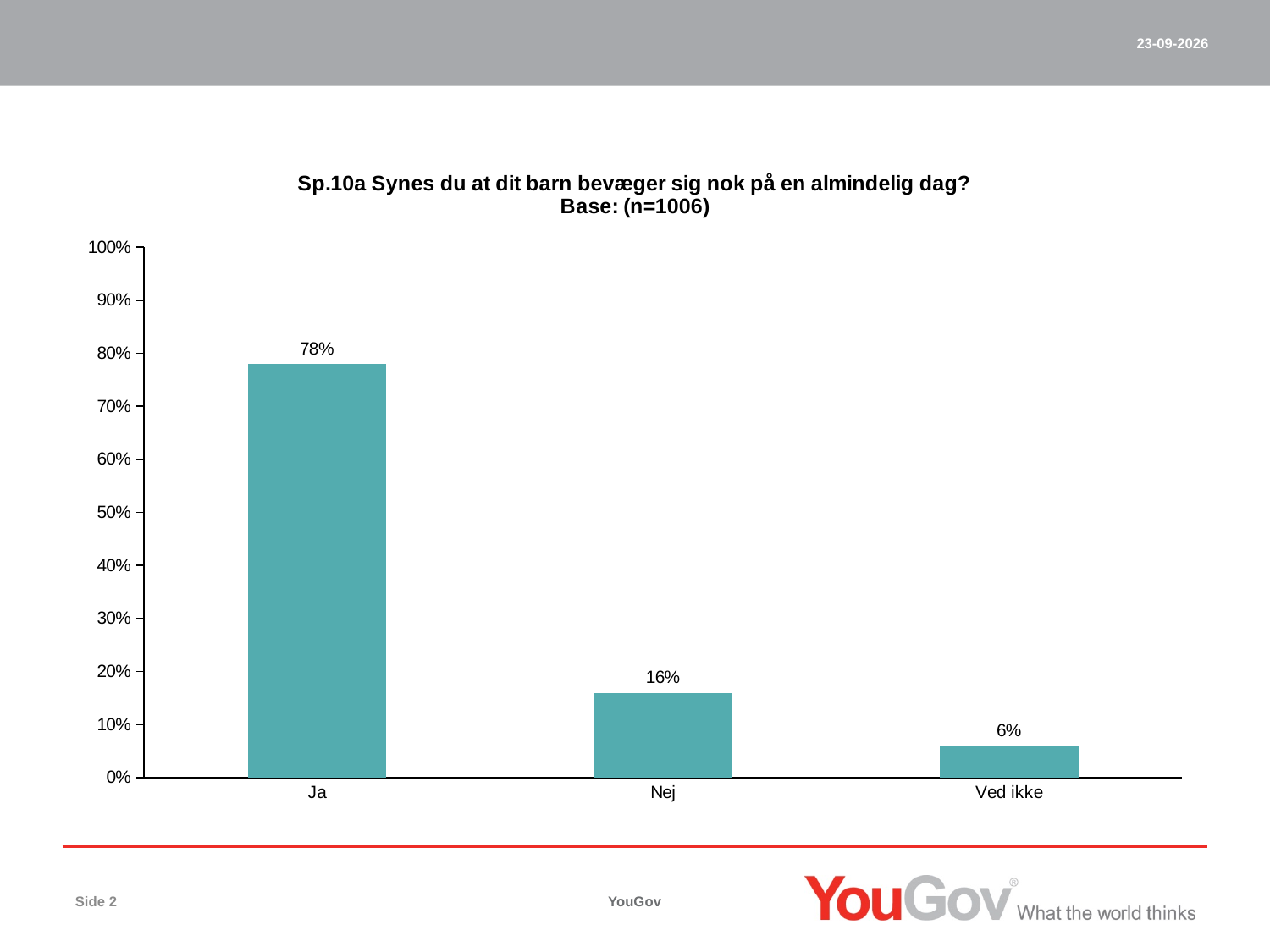
What is the value for Ja? 78% Which is larger, the value for Nej or the value for Ved ikke? Nej Which category has the highest value? Ja What base size (n) is stated in the chart title? n=1006 How many categories are shown on the x axis? 3 What kind of chart is shown on the slide? bar chart Is the value for Ja greater or less than 70%? greater Which category has the lowest value? Ved ikke What is the difference between the values for Ja and Nej? 62% What is the difference between the values for Nej and Ved ikke? 10% What is the value for Nej? 16% What is the value for Ved ikke? 6%